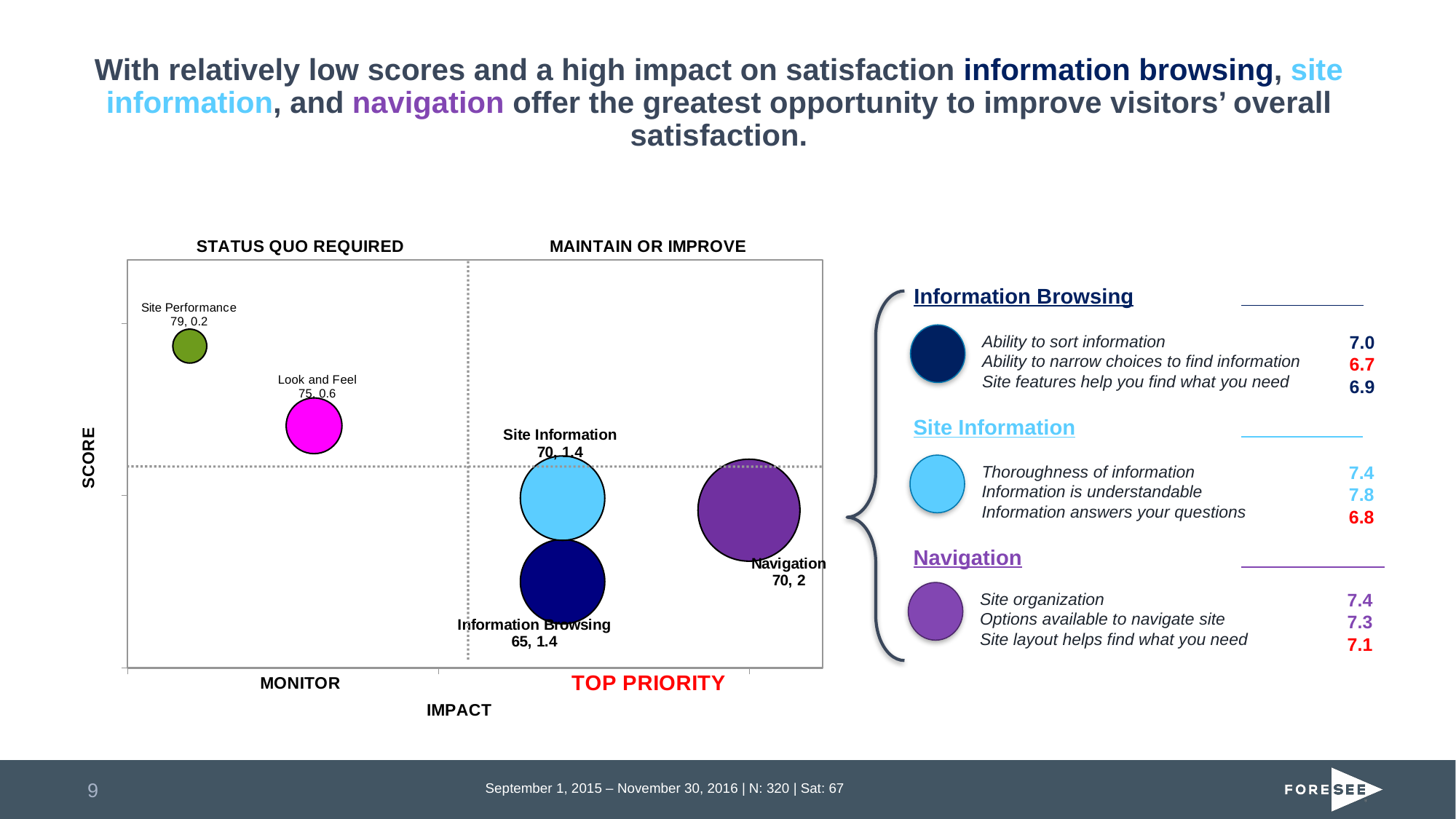
Which category has the lowest score on the chart? Information Browsing What is the difference in score between Site Performance and Information Browsing? 14 What are the values labelled for Information Browsing on the chart? 65, 1.4 What are the values labelled for Look and Feel on the chart? 75, 0.6 What are the values labelled for Navigation on the chart? 70, 2 What kind of chart is shown on the slide? Bubble chart What is the label of the vertical axis of the chart? SCORE Which has the larger impact value, Navigation or Site Information? Navigation Which category has the highest impact value on the chart? Navigation How many bubbles (categories) are plotted on the chart? 5 What are the values labelled for Site Performance on the chart? 79, 0.2 Which category has the highest score on the chart? Site Performance